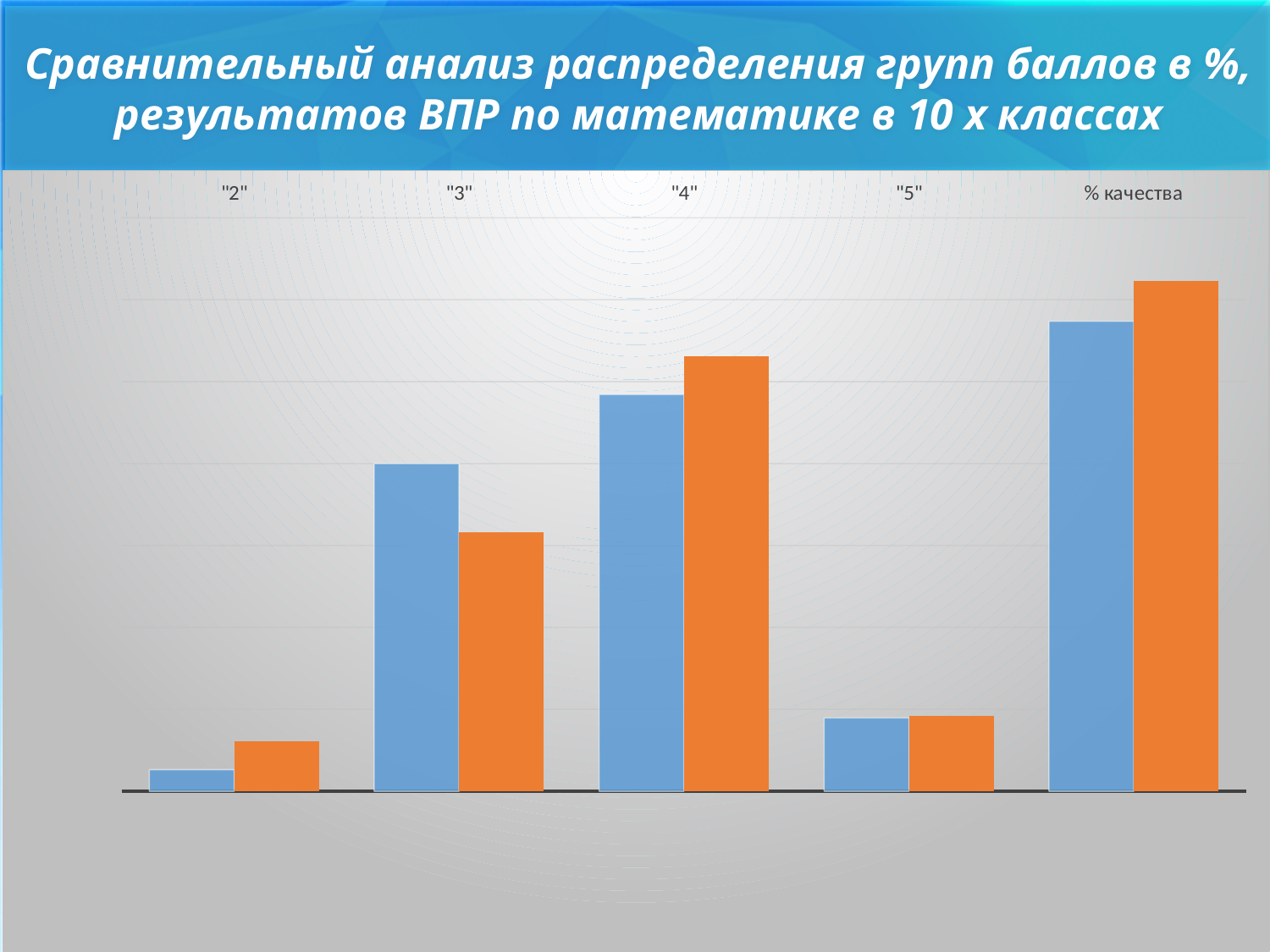
Which category has the tallest blue bar? % качества For the category "% качества", which bar is taller, the blue one or the orange one? orange What kind of chart is shown on the slide? bar chart What is the title of the slide containing the chart? Сравнительный анализ распределения групп баллов в %, результатов ВПР по математике в 10 х классах How many categories are shown along the x axis of the chart? 5 For the category "2", which bar is taller, the blue one or the orange one? orange What two colours are used for the bars in the chart? blue and orange Which category has the tallest orange bar? % качества For the category "4", which bar is taller, the blue one or the orange one? orange Which category has the shortest blue bar? "2" Which category has the shortest orange bar? "2"